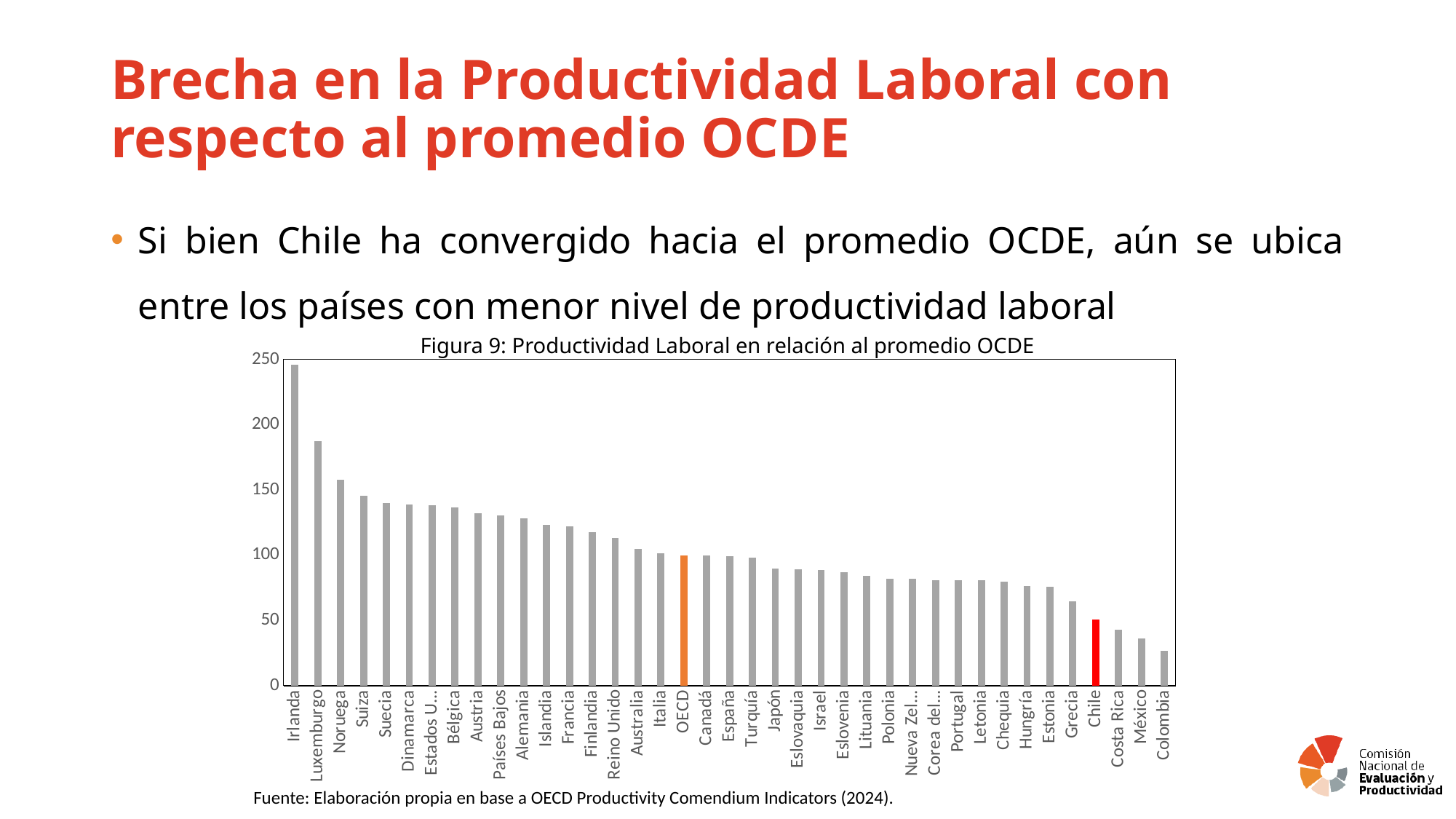
Which has a higher value, Chile or Costa Rica? Chile Is the value for Colombia greater or less than 50? less Which country has the lowest value in Figura 9? Colombia Is the value for Irlanda greater or less than 200? greater Which country has the highest labour productivity relative to the OECD average in Figura 9? Irlanda Is the value for Chile greater or less than 100? less Which has a higher value, Luxemburgo or Noruega? Luxemburgo Do the bar values rise or fall from left to right along the x axis? fall What kind of chart is shown in Figura 9? bar chart What colour is the bar for Chile? red